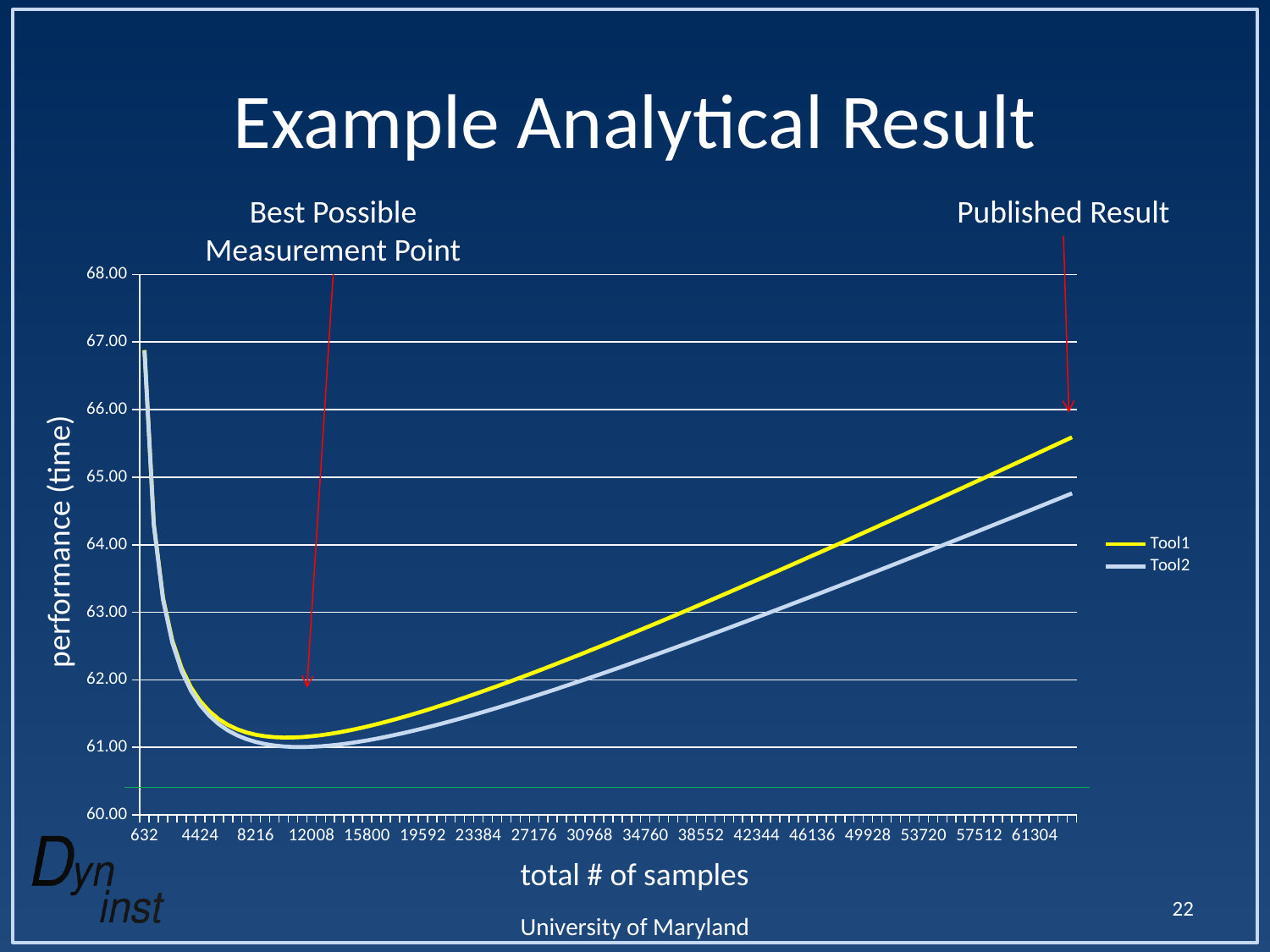
Is the value for Tool1 at 61304 samples greater or less than 65.00? greater What kind of chart is shown on the slide? line chart How many tick labels are printed along the x axis? 17 How many series does the legend list? 2 What are the names of the two series in the legend? Tool1 and Tool2 Is the value for Tool2 at 34760 samples greater or less than 63.00? less Is the value for Tool1 at 34760 samples greater or less than 63.00? less Do the values for Tool1 rise or fall between 30968 and 61304 samples? rise What is the label of the vertical axis? performance (time) At the right end of the x axis (61304 samples), which series has the higher performance value, Tool1 or Tool2? Tool1